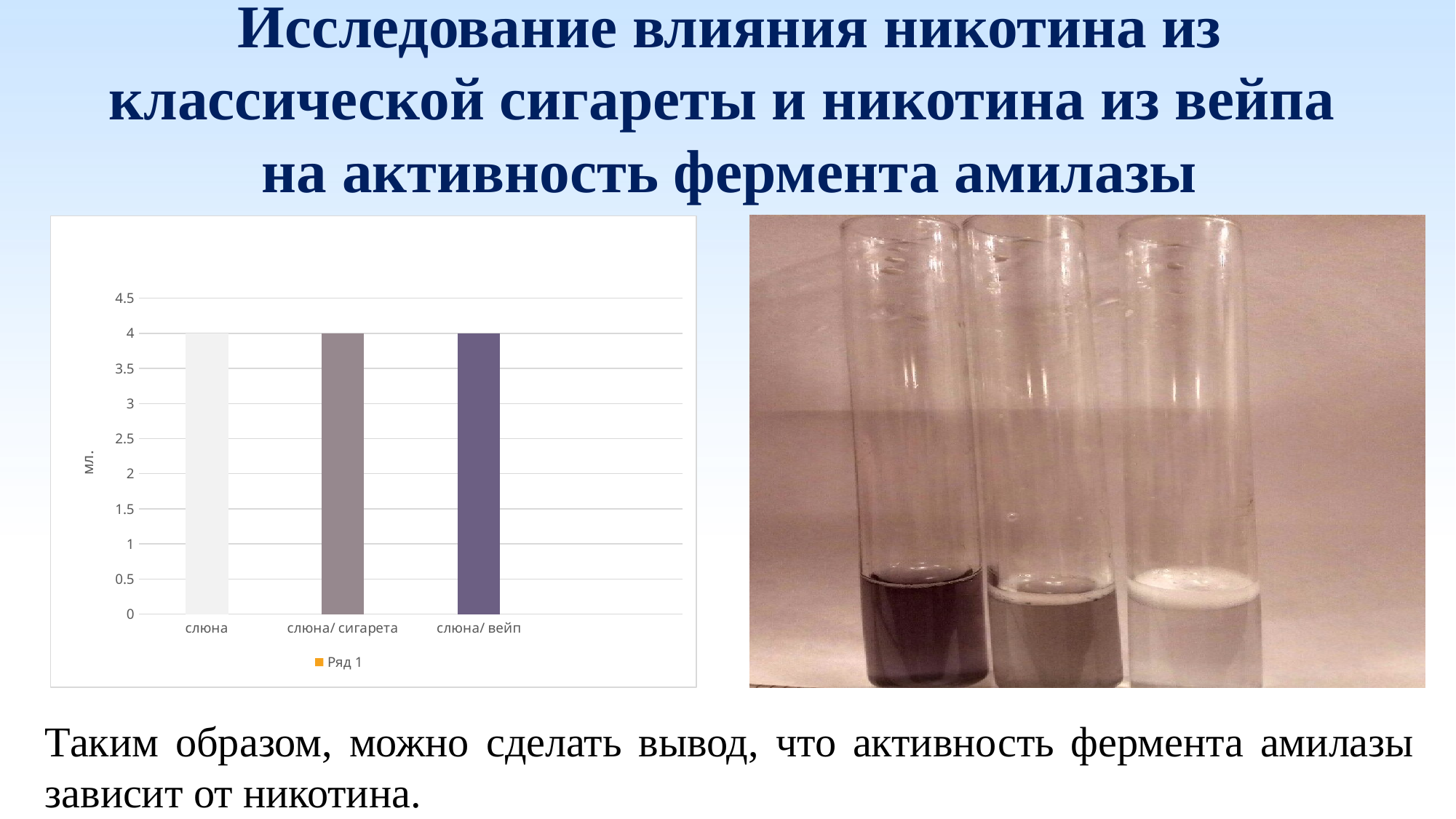
Is the value for "слюна" greater or less than 4.5? less What is the name of the series shown in the chart legend? Ряд 1 Do the values rise, fall, or stay the same across the categories from left to right? stay the same What is the label on the vertical axis of the chart? мл. How many categories are shown on the x axis of the chart? 3 What is the value for "слюна/ сигарета" in the chart? 4 How many series does the chart legend list? 1 Is the value for "слюна/ вейп" greater or less than 3? greater What is the value for "слюна" in the chart? 4 What type of chart is shown on the slide? bar chart What is the difference between the values for "слюна" and "слюна/ сигарета"? 0 What is the value for "слюна/ вейп" in the chart? 4